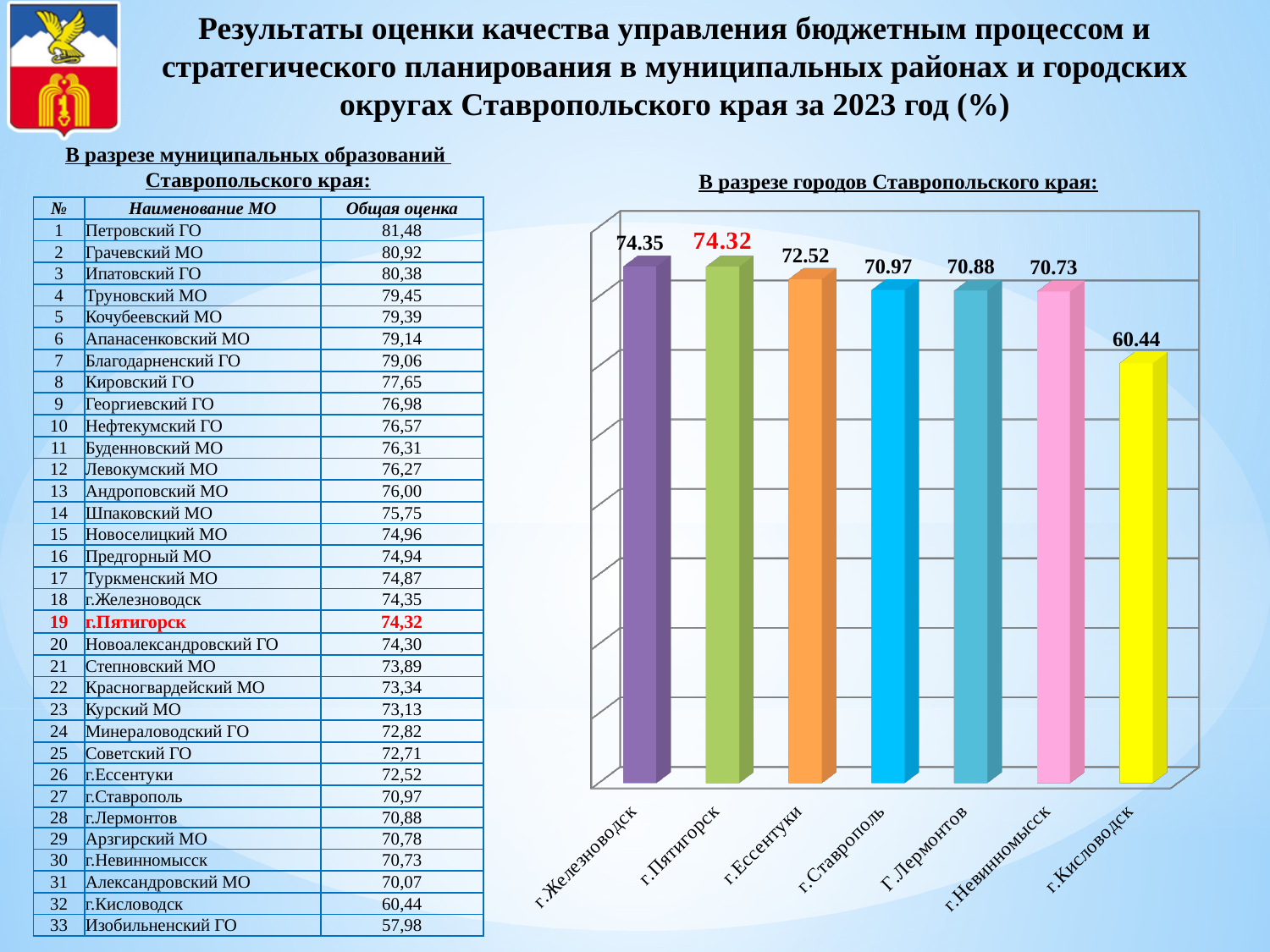
Which city has the highest value in the chart? г.Железноводск What is the difference between the values for г.Ессентуки and г.Ставрополь in the chart? 1.55 How many cities are shown in the chart? 7 Which has a larger value in the chart, г.Невинномысск or г.Кисловодск? г.Невинномысск Which city has the lowest value in the chart? г.Кисловодск What is the value shown for г.Кисловодск in the chart? 60.44 What is the difference between the values for г.Железноводск and г.Кисловодск in the chart? 13.91 What is the value shown for г.Ставрополь in the chart? 70.97 What is the value shown for г.Лермонтов in the chart? 70.88 What kind of chart is shown on the slide? Bar chart What is the value shown for г.Ессентуки in the chart? 72.52 Do the values in the chart rise or fall from left to right? Fall